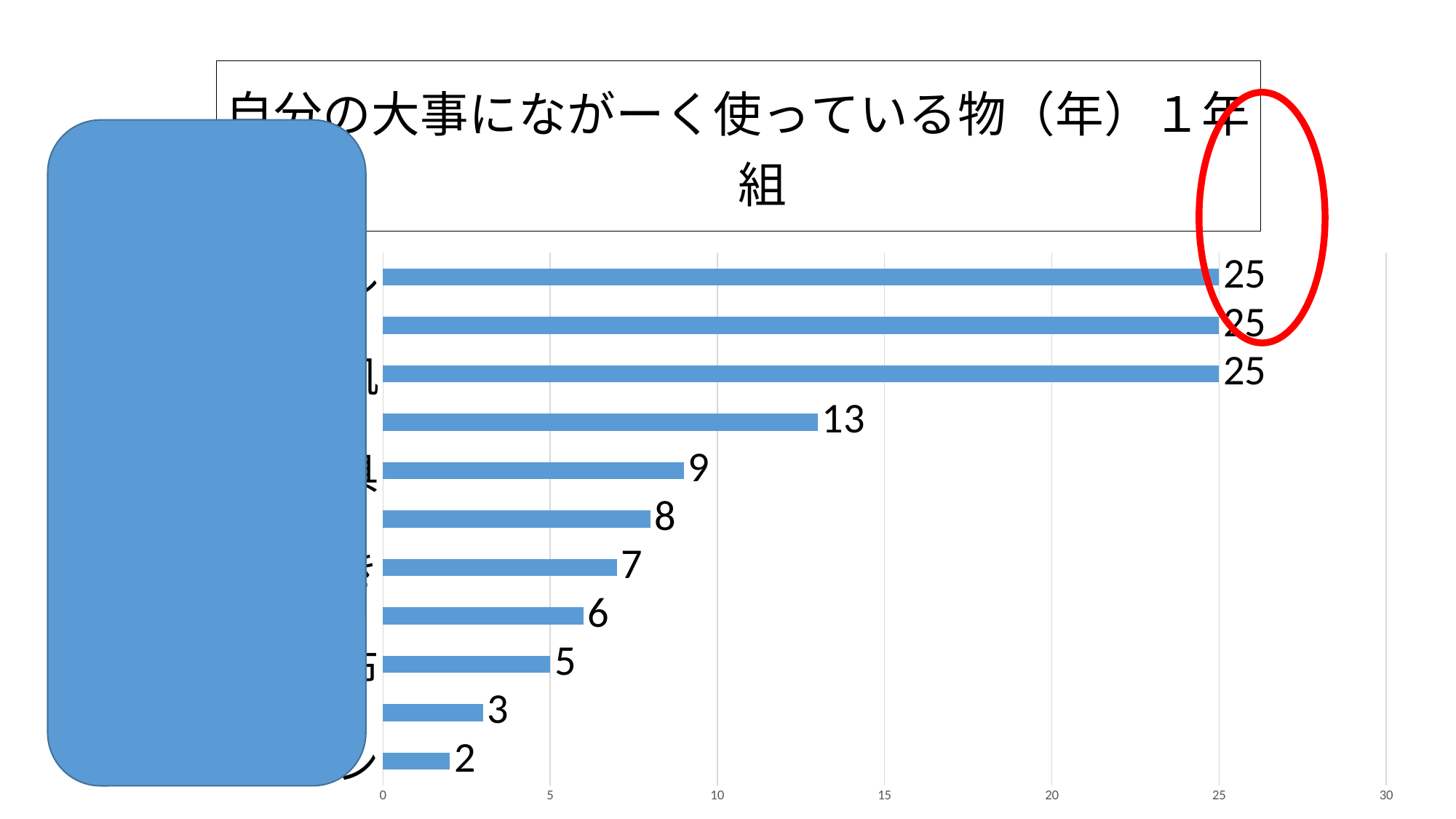
What is the difference between the topmost bar (25) and the bottom bar (2)? 23 What is the value of the topmost bar in the chart? 25 What is the value of the bottom bar in the chart? 2 What is the largest tick value shown on the horizontal axis? 30 How many bars are plotted in the chart? 11 What kind of chart is shown on the slide? bar chart What is the value of the fourth bar from the top? 13 Which is larger, the fourth bar from the top or the fifth bar from the top? the fourth bar from the top Do the bar values increase or decrease going from the top of the chart to the bottom? decrease How many bars have a value of 25? 3 What is the highest value shown in the chart? 25 What is the lowest value shown in the chart? 2